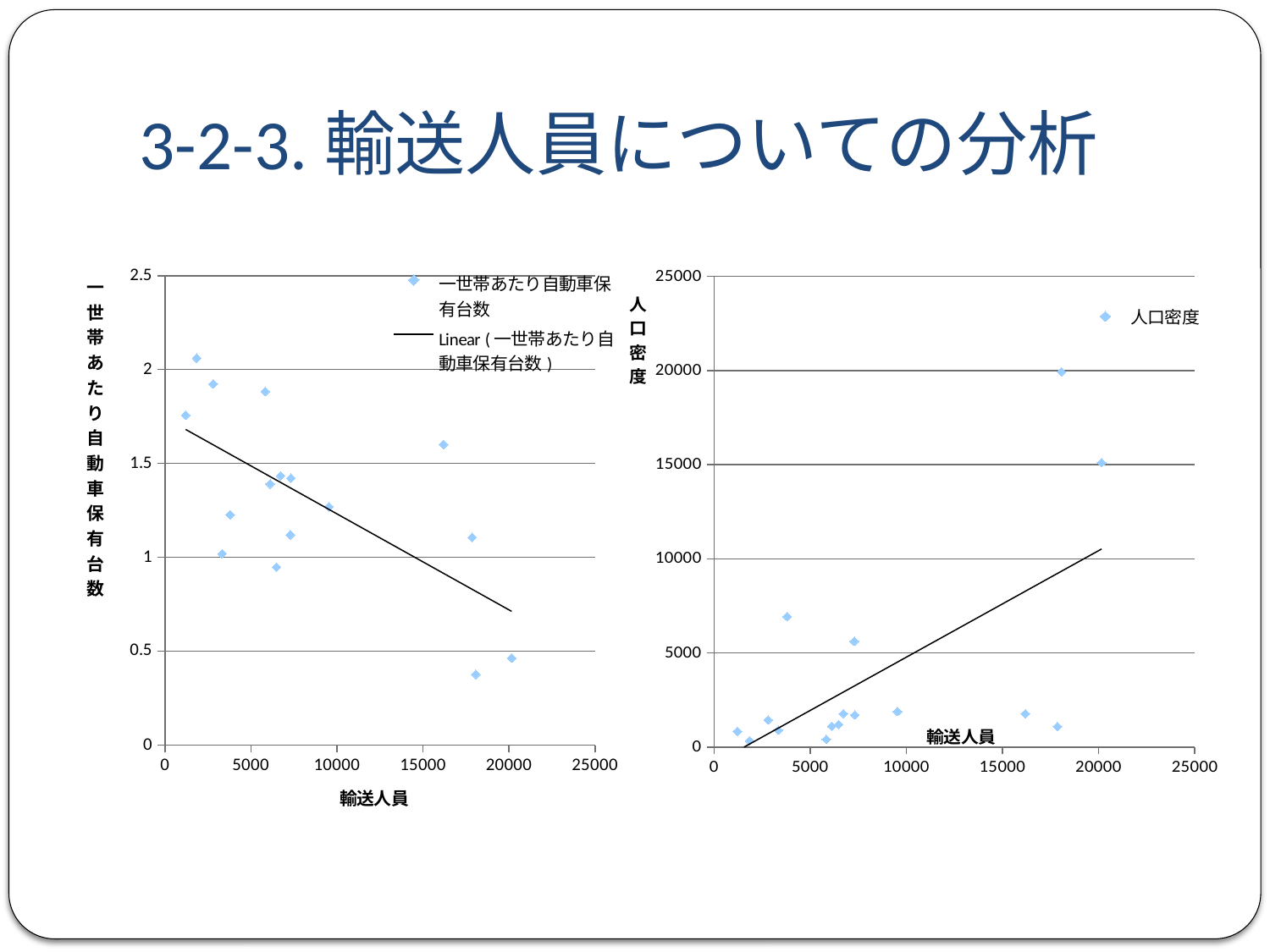
In the right chart, does the fitted linear trend line rise or fall as 輸送人員 increases? rise What is the x-axis title of the right chart? 輸送人員 In the right chart, is the 人口密度 of the point near 輸送人員 of about 4000 that lies above the trend line greater or less than 5000? greater What is the legend entry for the data points in the right chart? 人口密度 In the left chart, does the fitted linear trend line rise or fall as 輸送人員 increases? fall In the left chart, is the value of the point at the far right (near 輸送人員 of about 20000) greater or less than 1? less What kind of chart is the right chart on the slide? scatter chart How many entries does the legend of the right chart list? 1 What kind of chart is the left chart on the slide? scatter chart How many entries does the legend of the left chart list? 2